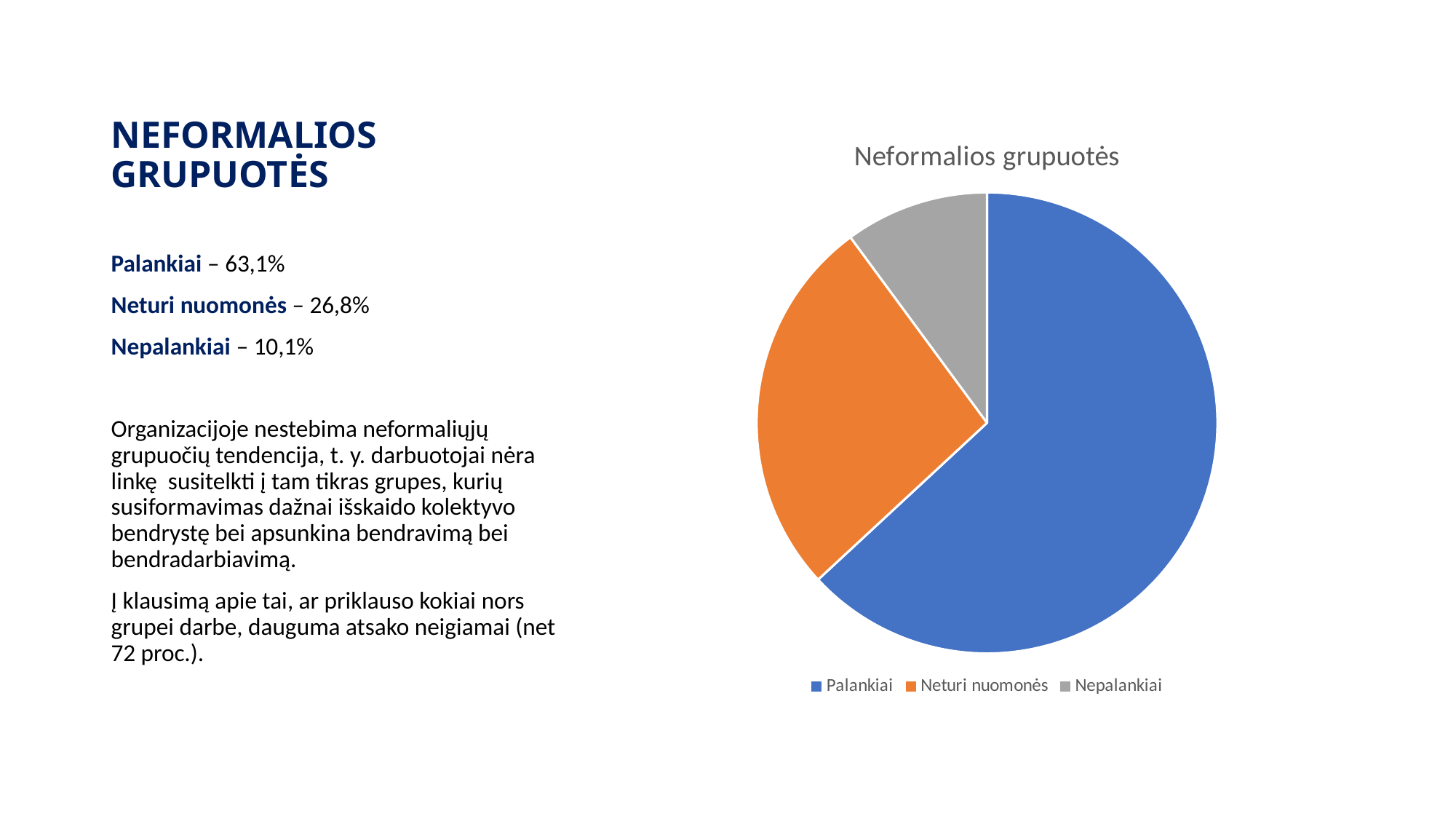
Which is larger, the slice for Neturi nuomonės or the slice for Nepalankiai? Neturi nuomonės What is the title of the chart? Neformalios grupuotės What share of the pie does Nepalankiai represent? 10,1% Which category has the smallest slice of the pie? Nepalankiai What kind of chart is shown on the slide? pie chart What share of the pie does Palankiai represent? 63,1% Which colour is used for the Neturi nuomonės slice? orange What is the difference between the Palankiai share and the Neturi nuomonės share? 36,3% How many entries does the chart legend list? 3 Which category has the largest slice of the pie? Palankiai What share of the pie does Neturi nuomonės represent? 26,8% How many slices does the pie chart have? 3